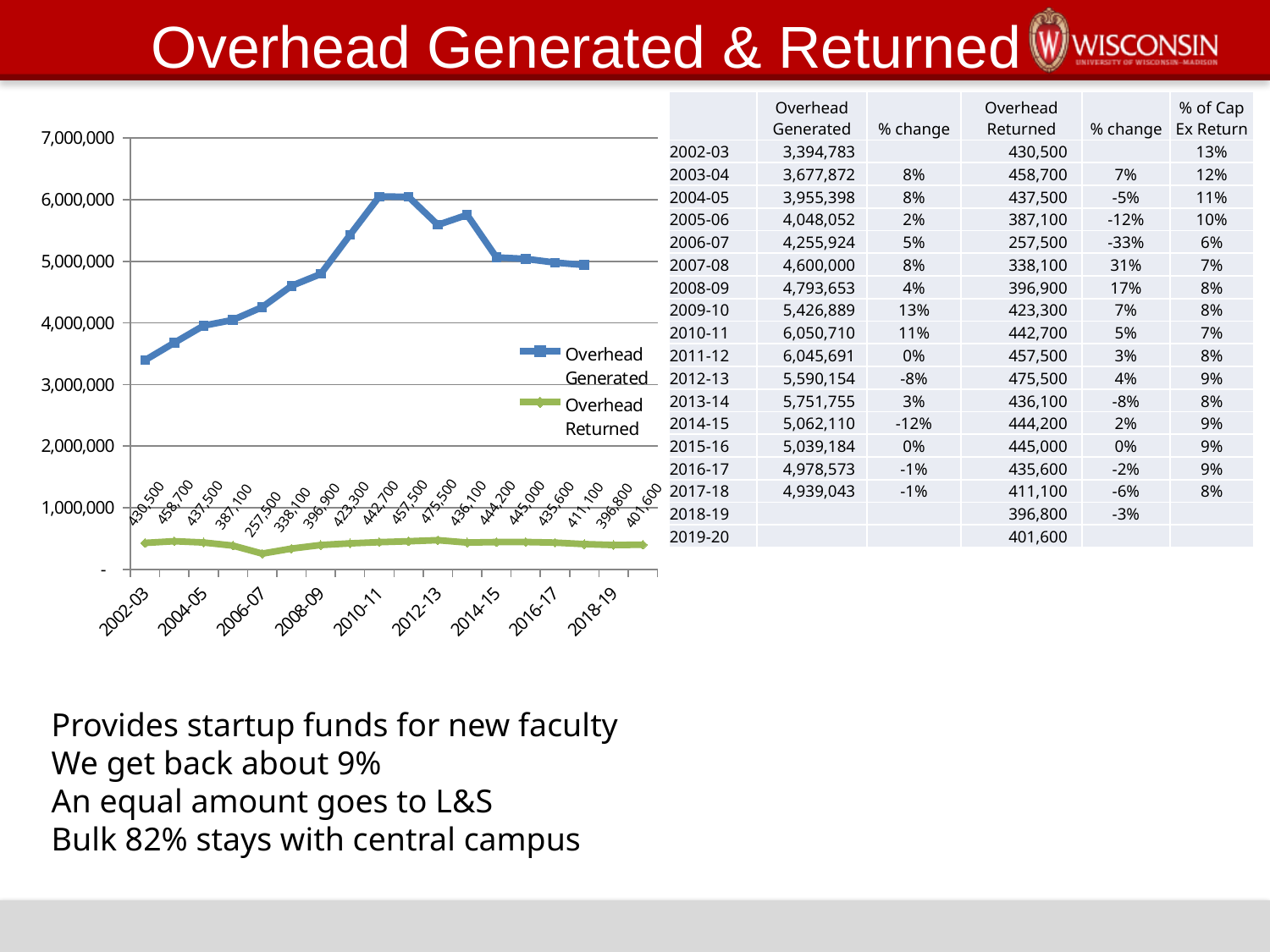
What kind of chart is shown on the slide? line chart What is the Overhead Returned value for 2006-07? 257,500 What is the highest Overhead Returned value shown on the chart? 475,500 How many series does the chart legend list? 2 In 2010-11, which series has the larger value, Overhead Generated or Overhead Returned? Overhead Generated Is the Overhead Generated value for 2008-09 greater or less than 5,000,000? less What is the difference between the highest Overhead Returned value (475,500) and the lowest (257,500)? 218,000 Does the Overhead Generated line rise or fall from 2002-03 to 2010-11? rise Is the Overhead Generated value for 2002-03 greater or less than 4,000,000? less In which year is Overhead Returned lowest? 2006-07 What is the Overhead Returned value for 2002-03? 430,500 What colour is the Overhead Generated line? blue